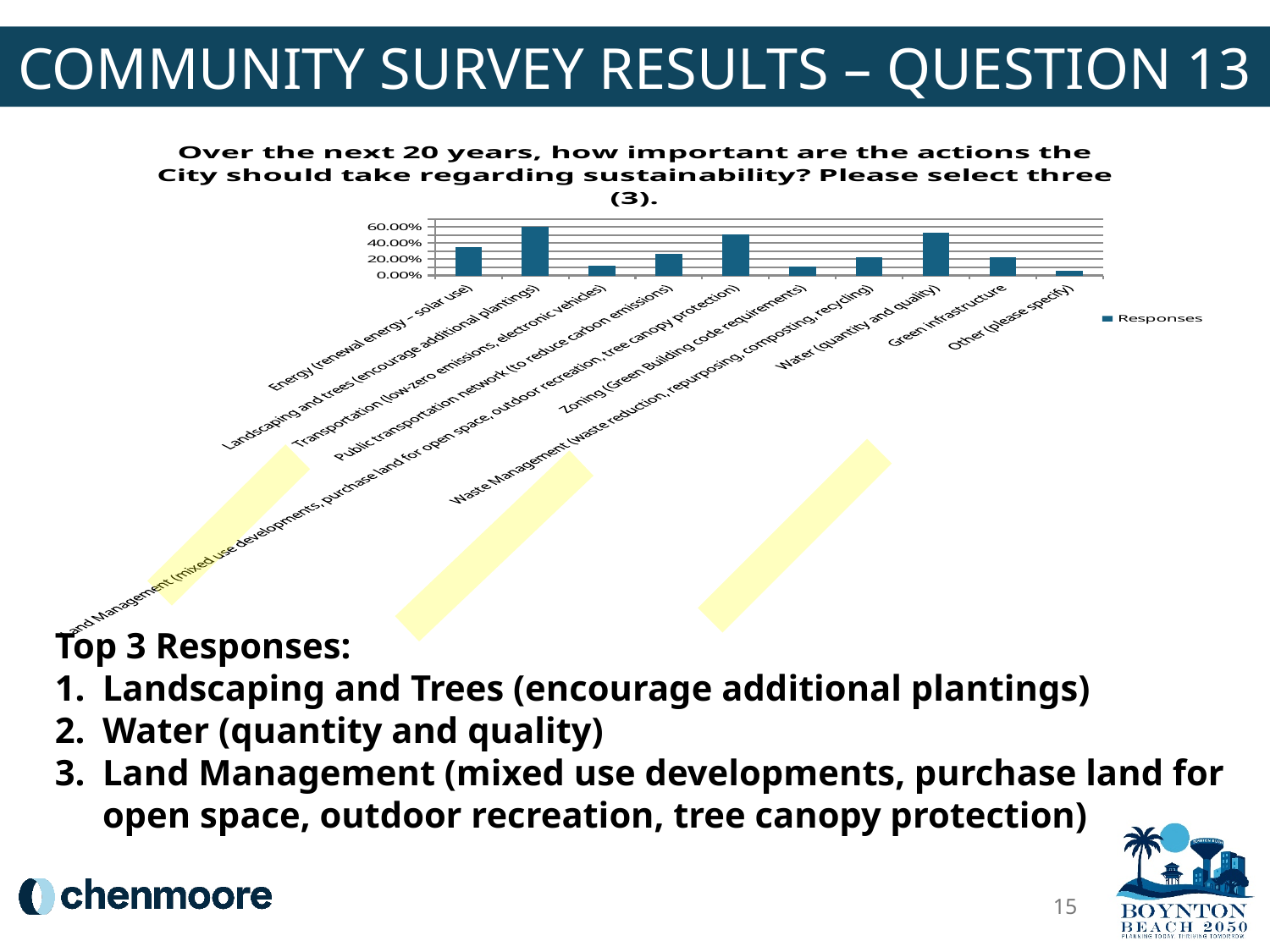
Which has the larger value: Zoning (Green Building code requirements) or Water (quantity and quality)? Water (quantity and quality) Is the value for Water (quantity and quality) greater or less than 40.00%? greater Is the value for Energy (renewal energy – solar use) greater or less than 20.00%? greater What kind of chart is shown on the slide? Bar chart Is the value for Transportation (low-zero emissions, electronic vehicles) greater or less than 20.00%? less Which category has the highest value in the chart? Landscaping and trees (encourage additional plantings) Which has the larger value: Energy (renewal energy – solar use) or Transportation (low-zero emissions, electronic vehicles)? Energy (renewal energy – solar use) How many categories are plotted on the chart? 10 How many series does the chart's legend list? 1 Which category has the lowest value in the chart? Other (please specify) What is the name of the series shown in the chart's legend? Responses